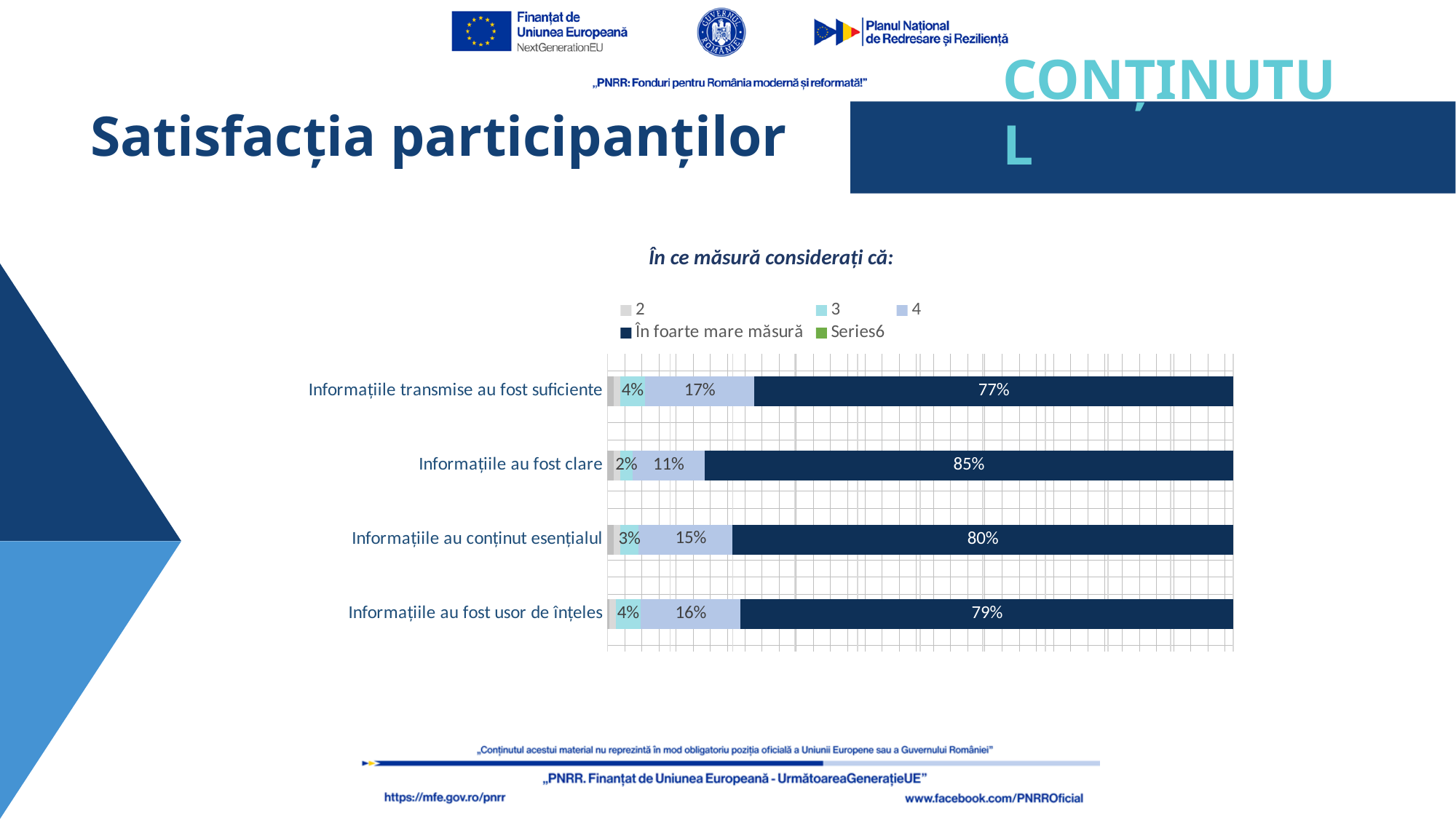
Which category has the highest 'În foarte mare măsură' value? Informațiile au fost clare What type of chart is shown on the slide? stacked bar chart Which category has the lowest 'În foarte mare măsură' value? Informațiile transmise au fost suficiente What is the value of series '3' for 'Informațiile au conținut esențialul'? 3% What is the 'În foarte mare măsură' value for 'Informațiile au fost clare'? 85% What is the 'În foarte mare măsură' value for 'Informațiile au fost usor de înțeles'? 79% What is the value of series '4' for 'Informațiile transmise au fost suficiente'? 17% What is the title of the chart? În ce măsură considerați că: What is the difference between the 'În foarte mare măsură' values for 'Informațiile au fost clare' and 'Informațiile transmise au fost suficiente'? 8% How many categories are shown on the chart? 4 How many series does the chart legend list? 5 Which is larger: the series '4' value for 'Informațiile au conținut esențialul' or for 'Informațiile au fost clare'? Informațiile au conținut esențialul